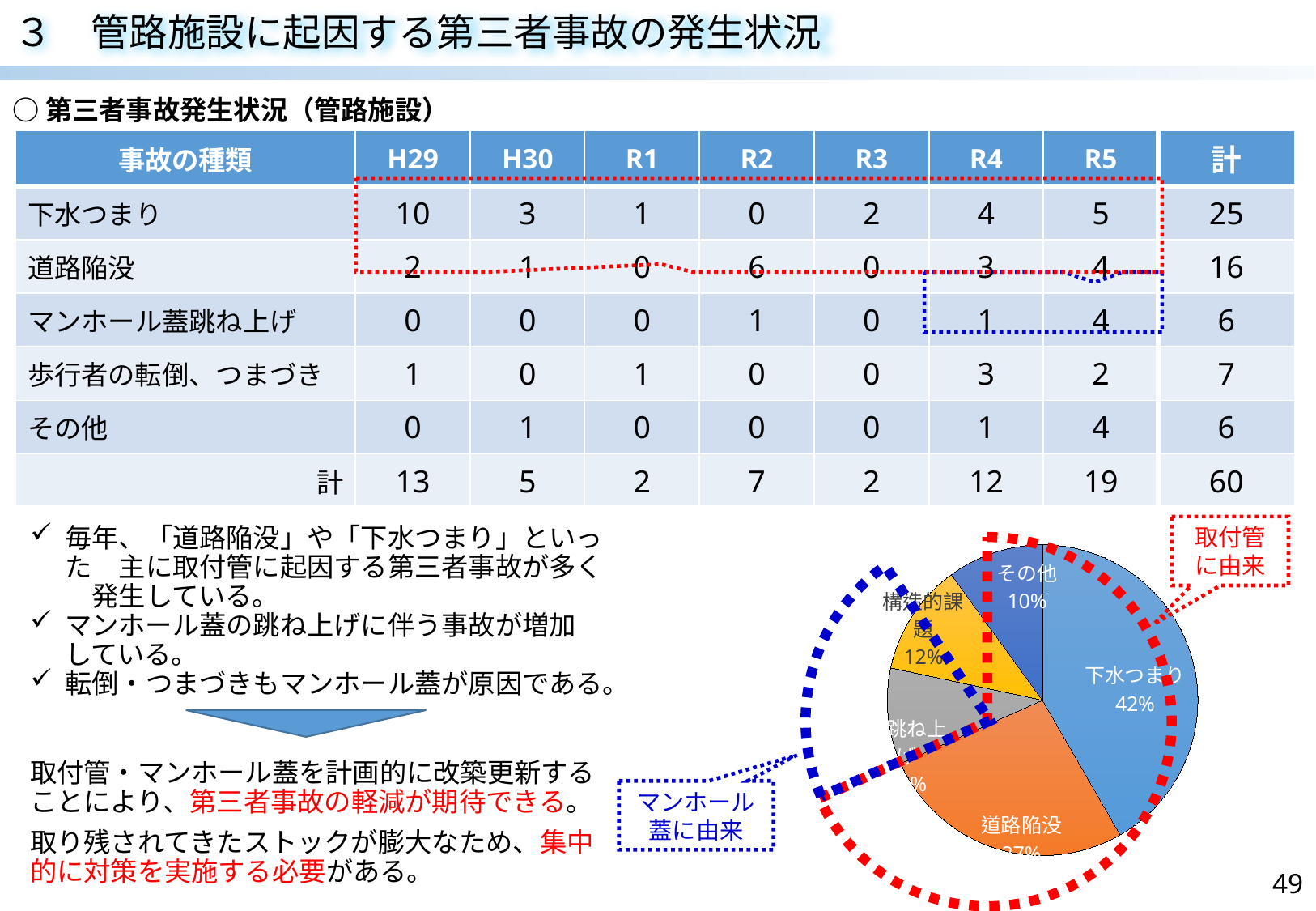
What kind of chart is shown on the slide? Pie chart What share of the pie chart does 構造的課題 account for? 12% By how many percentage points does the 下水つまり slice exceed the その他 slice? 32 percentage points In the pie chart, which slice is larger, 下水つまり or その他? 下水つまり Which category has the largest slice in the pie chart? 下水つまり In the pie chart, which slice is larger, 道路陥没 or 下水つまり? 下水つまり What colour is the 下水つまり slice in the pie chart? Blue What share of the pie chart does その他 account for? 10% How many slices does the pie chart have? 5 In the pie chart, which slice is larger, 構造的課題 or その他? 構造的課題 What share of the pie chart does 下水つまり account for? 42% By how many percentage points does the 構造的課題 slice exceed the その他 slice? 2 percentage points